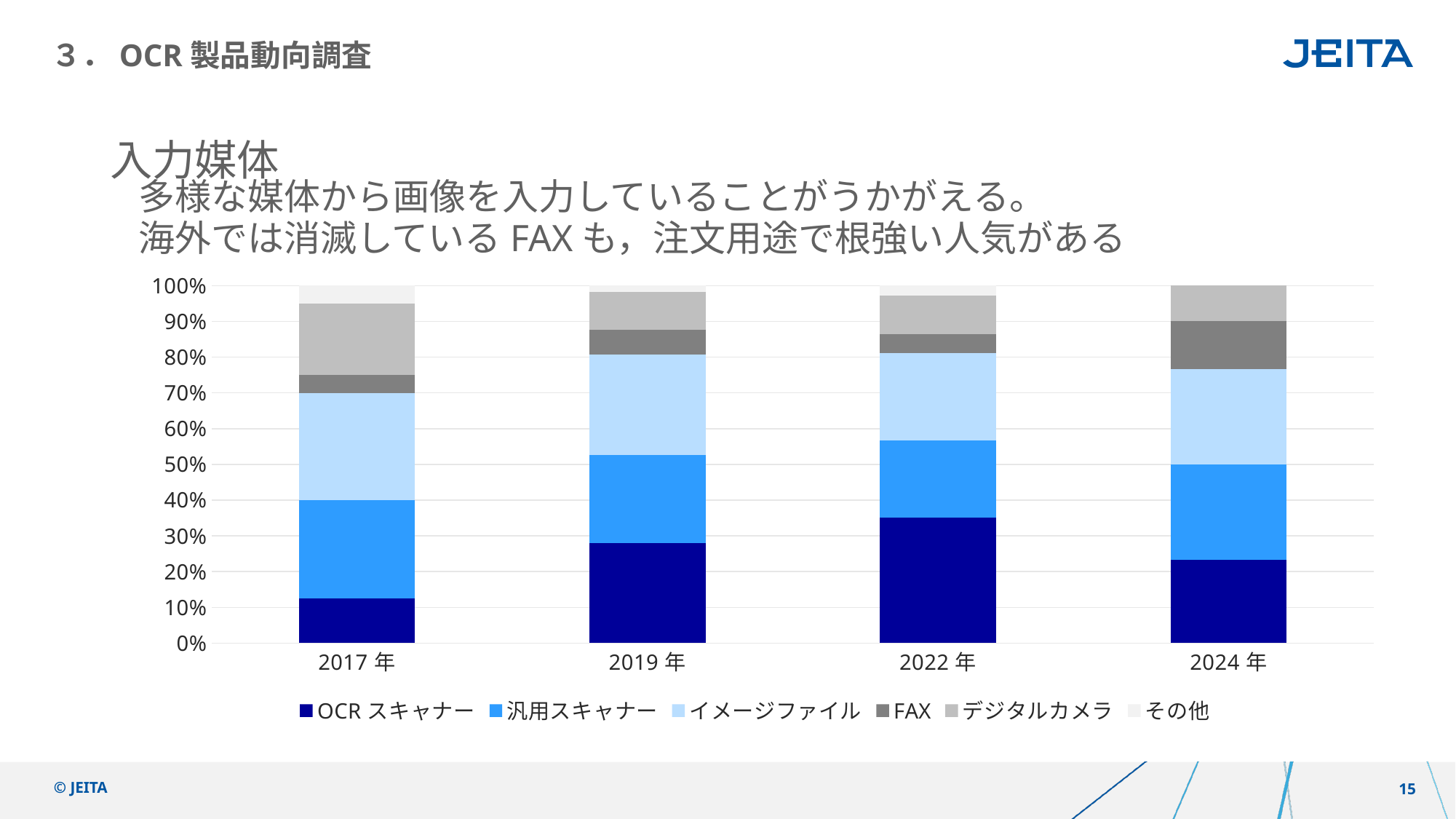
In which year is the デジタルカメラ share the largest? 2017 年 How many years (categories) are shown on the x axis of the chart? 4 Is the OCR スキャナー share for 2019 年 greater or less than 20%? greater How many series does the chart's legend list? 6 What kind of chart is shown on the slide? Stacked bar chart Which series is listed first in the chart's legend? OCR スキャナー Does the OCR スキャナー share rise or fall from 2017 年 to 2022 年? rise In which year is the OCR スキャナー share the smallest? 2017 年 Is the OCR スキャナー share for 2017 年 greater or less than 20%? less Is the FAX share larger in 2017 年 or in 2024 年? 2024 年 Is the OCR スキャナー share for 2022 年 greater or less than 30%? greater In which year is the OCR スキャナー share the largest? 2022 年